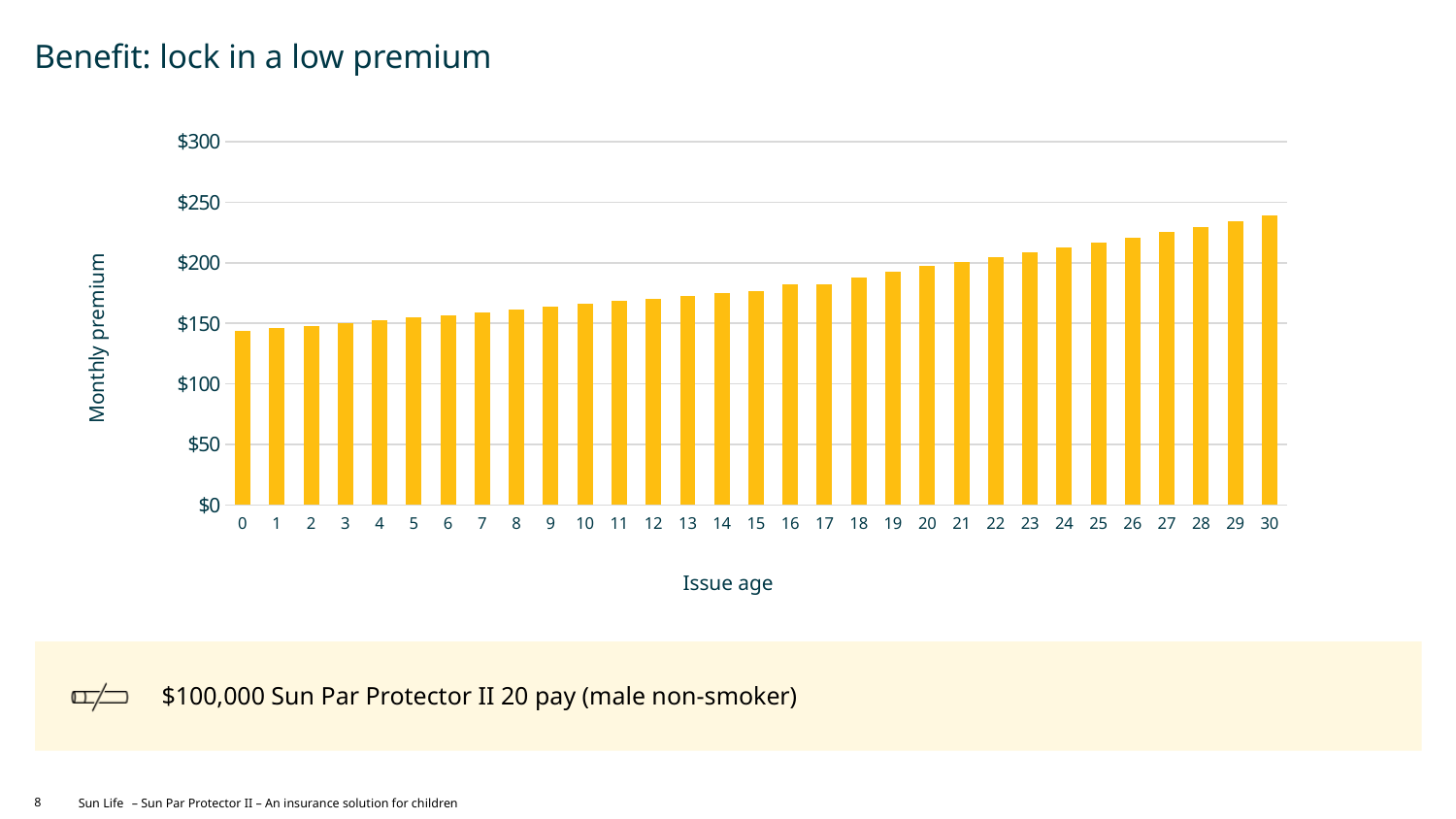
Which issue age has the lowest monthly premium? 0 Is the monthly premium for issue age 15 greater or less than $150? greater What kind of chart is shown on the slide? bar chart How many issue ages are plotted on the chart? 31 Which issue age has the highest monthly premium? 30 Which has the larger monthly premium, issue age 10 or issue age 20? issue age 20 Is the monthly premium for issue age 0 greater or less than $100? greater Do the monthly premiums rise or fall as issue age increases? rise What is the label on the horizontal axis of the chart? Issue age Is the monthly premium for issue age 30 greater or less than $200? greater What is the label on the vertical axis of the chart? Monthly premium